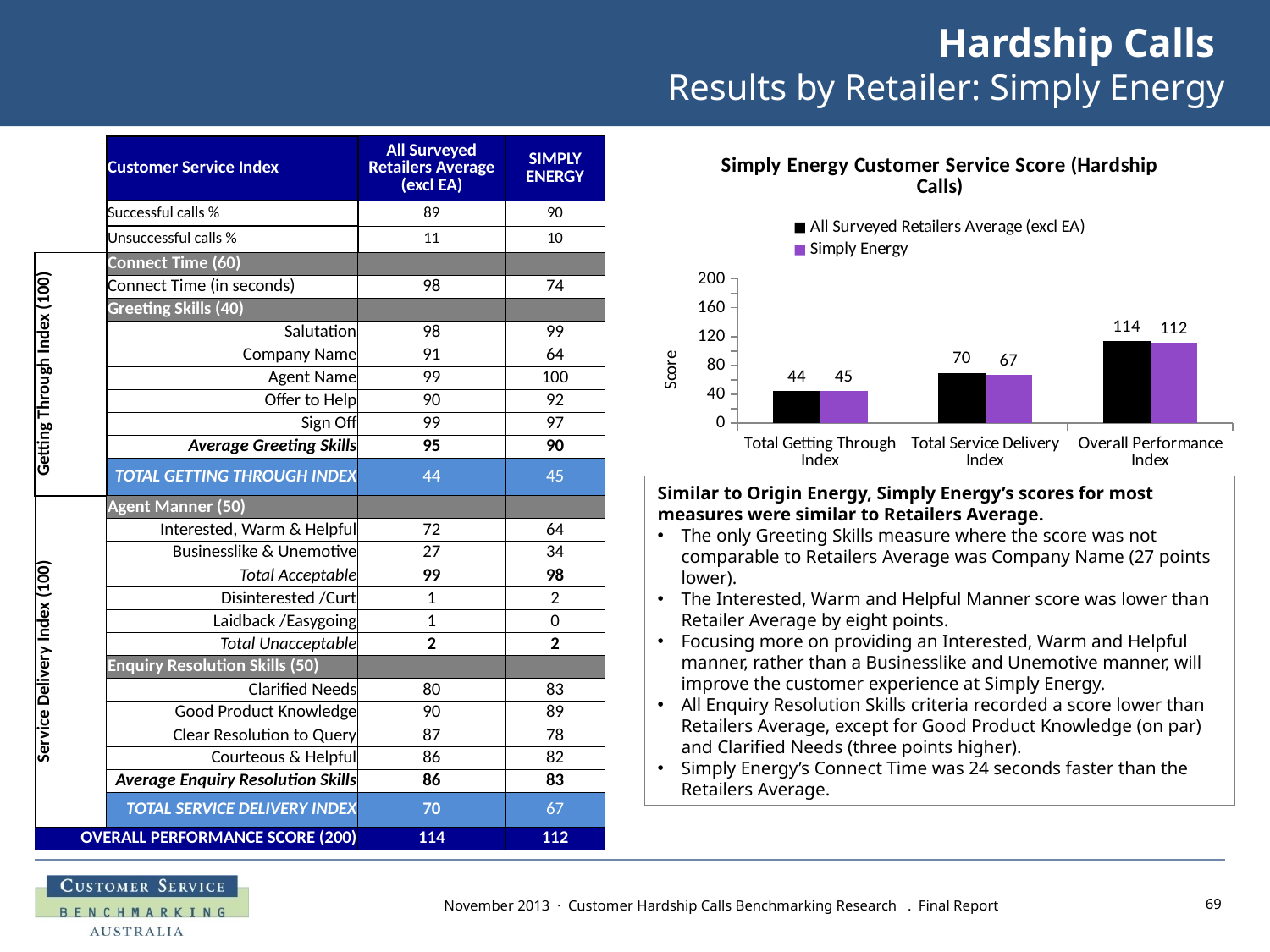
What is the Simply Energy value for the Total Getting Through Index? 45 What is the Simply Energy value for the Overall Performance Index? 112 What is the All Surveyed Retailers Average (excl EA) value for the Total Service Delivery Index? 70 What is the difference between the All Surveyed Retailers Average and Simply Energy for the Total Service Delivery Index? 3 What is the title of the chart? Simply Energy Customer Service Score (Hardship Calls) How many categories are shown on the x axis of the chart? 3 What kind of chart is shown on the slide? Bar chart Which category has the highest value for Simply Energy? Overall Performance Index Which category has the lowest value for All Surveyed Retailers Average (excl EA)? Total Getting Through Index How many series does the chart legend list? 2 Is the All Surveyed Retailers Average value for the Overall Performance Index greater or less than 80? greater Which is larger for the Total Getting Through Index: All Surveyed Retailers Average (excl EA) or Simply Energy? Simply Energy